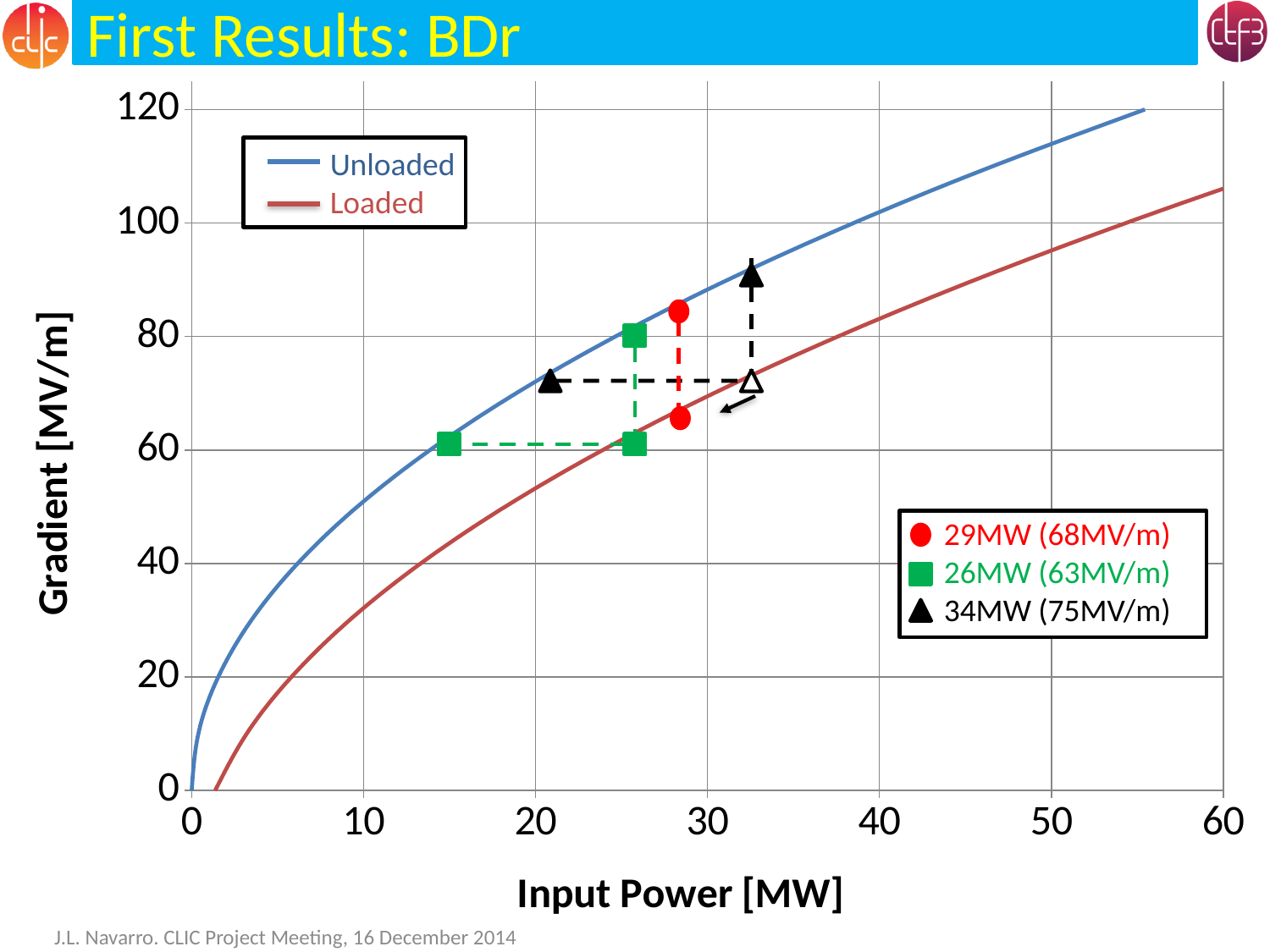
What is the difference in listed gradient between the 34MW marker and the 26MW marker? 12MV/m Is the Loaded gradient at 20 MW input power greater or less than 40? greater At an input power of 40 MW, which curve has the higher gradient, Unloaded or Loaded? Unloaded Is the Unloaded gradient at 50 MW input power greater or less than 100? greater Does the gradient rise or fall as input power increases along the x axis? rise What gradient is listed for the red circle marker (29MW) in the marker legend? 68MV/m How many series does the top-left legend list? 2 Which series is drawn in blue according to the top-left legend? Unloaded What input power is listed for the green square marker in the marker legend? 26MW What kind of chart is shown on the slide? line chart What is the label of the x axis? Input Power [MW] Which marker in the marker legend has the highest listed input power? 34MW (75MV/m)